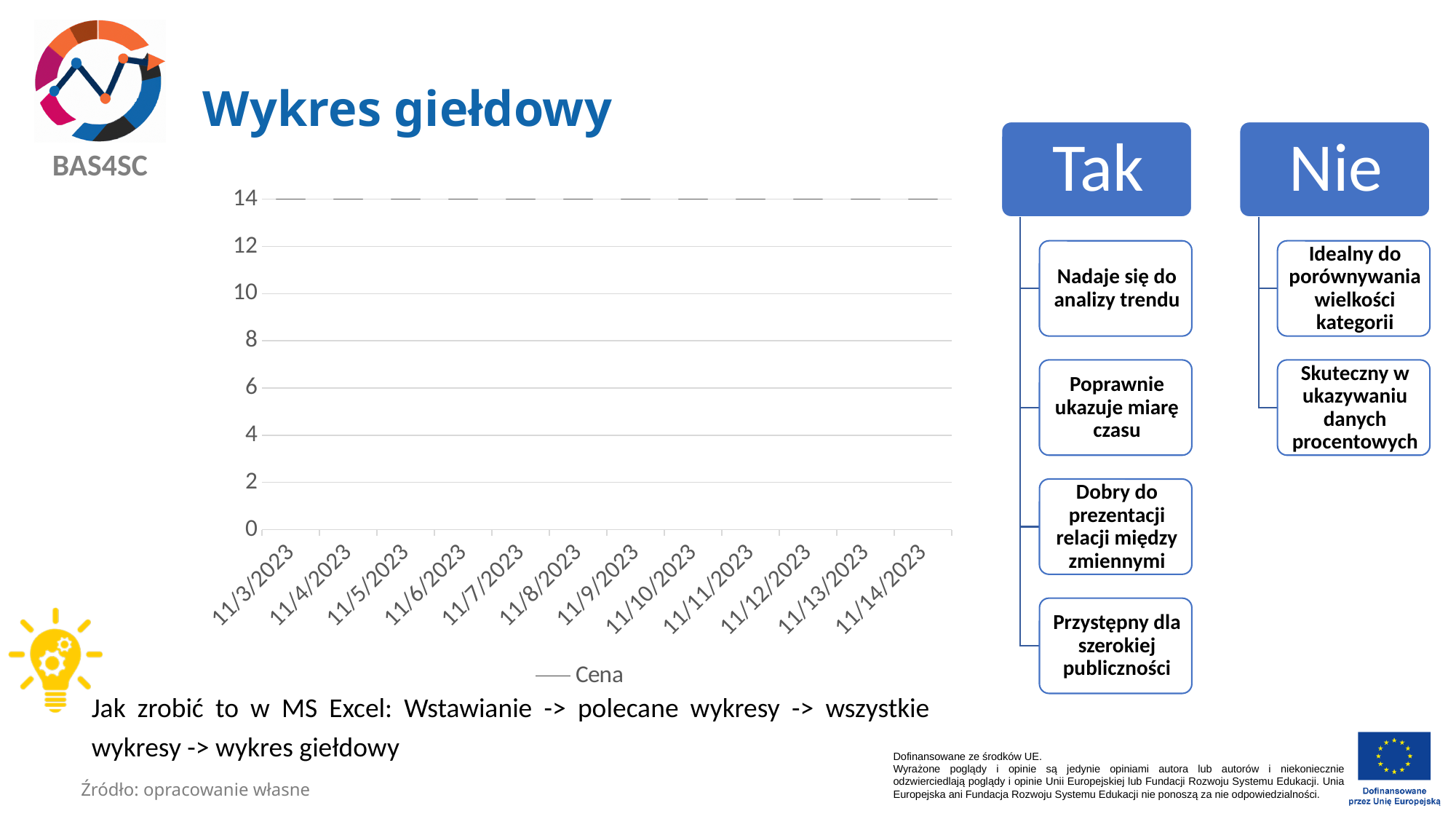
How many dates are shown on the x axis of the chart? 12 Is the value for Cena on 11/3/2023 greater or less than 10? greater What is the first date shown on the x axis of the chart? 11/3/2023 What kind of chart is shown on the slide? stock chart Is the value for Cena on 11/14/2023 greater or less than 8? greater How many series does the chart legend list? 1 What is the highest value shown on the y axis of the chart? 14 What is the name of the series shown in the chart legend? Cena What is the title of the chart on the slide? Wykres giełdowy What is the last date shown on the x axis of the chart? 11/14/2023